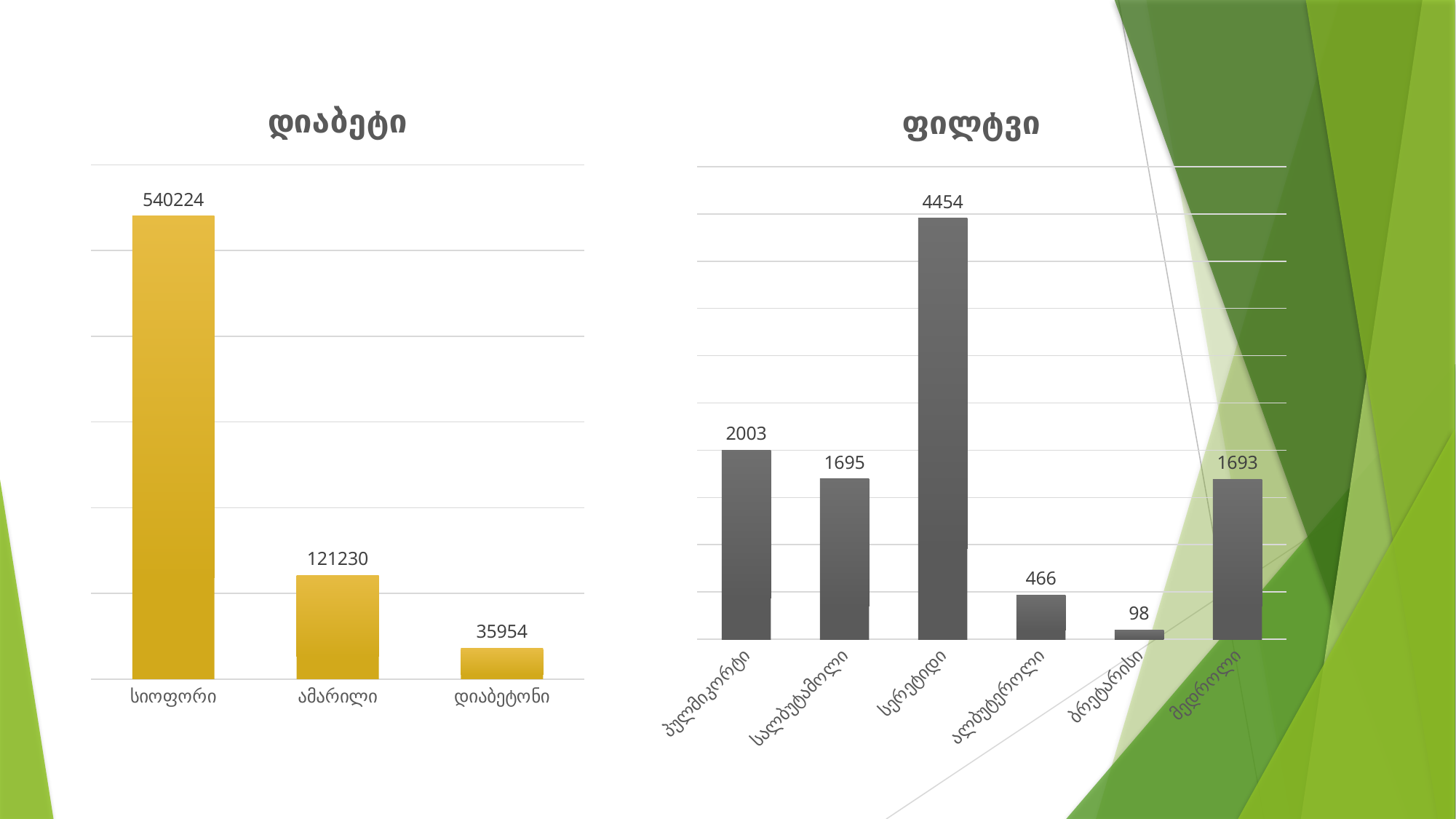
In the chart titled "დიაბეტი", what is the difference between the values for სიოფორი and ამარილი? 418994 In the chart titled "დიაბეტი", which category has the lowest value? დიაბეტონი In the chart titled "ფილტვი", how many categories are shown? 6 In the chart titled "ფილტვი", which is larger, the value for პულმიკორტი or the value for ალბუტეროლი? პულმიკორტი What kind of chart is the chart titled "ფილტვი"? bar chart In the chart titled "დიაბეტი", how many categories are shown? 3 In the chart titled "ფილტვი", what is the difference between the values for სალბუტამოლი and მედროლი? 2 In the chart titled "ფილტვი", what is the value for სერეტიდი? 4454 In the chart titled "ფილტვი", which category has the highest value? სერეტიდი In the chart titled "დიაბეტი", what is the value for სიოფორი? 540224 In the chart titled "დიაბეტი", what is the value for დიაბეტონი? 35954 In the chart titled "ფილტვი", what is the value for ბრეტარისი? 98